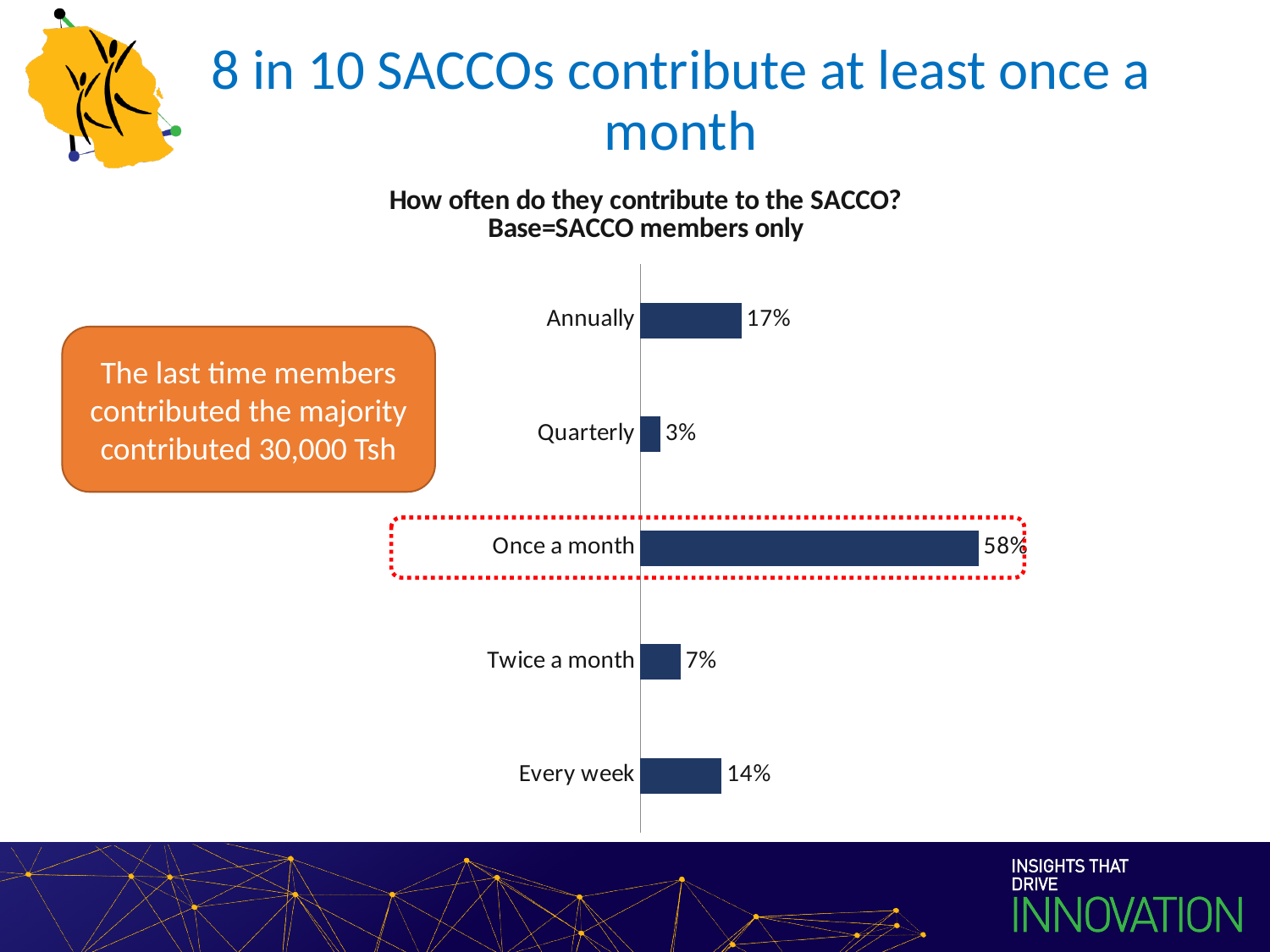
What is the difference in percentage points between 'Once a month' and 'Annually'? 41 What type of chart is shown on the slide? Bar chart What percentage of SACCO members contribute annually? 17% How many contribution frequency categories are shown in the chart? 5 What is the difference in percentage points between 'Every week' and 'Twice a month'? 7 Which is larger, the percentage for 'Annually' or for 'Every week'? Annually Which contribution frequency has the highest percentage? Once a month Which category is highlighted with a red dashed box? Once a month Which contribution frequency has the lowest percentage? Quarterly What percentage of SACCO members contribute once a month? 58% What percentage of SACCO members contribute every week? 14% What percentage of SACCO members contribute quarterly? 3%